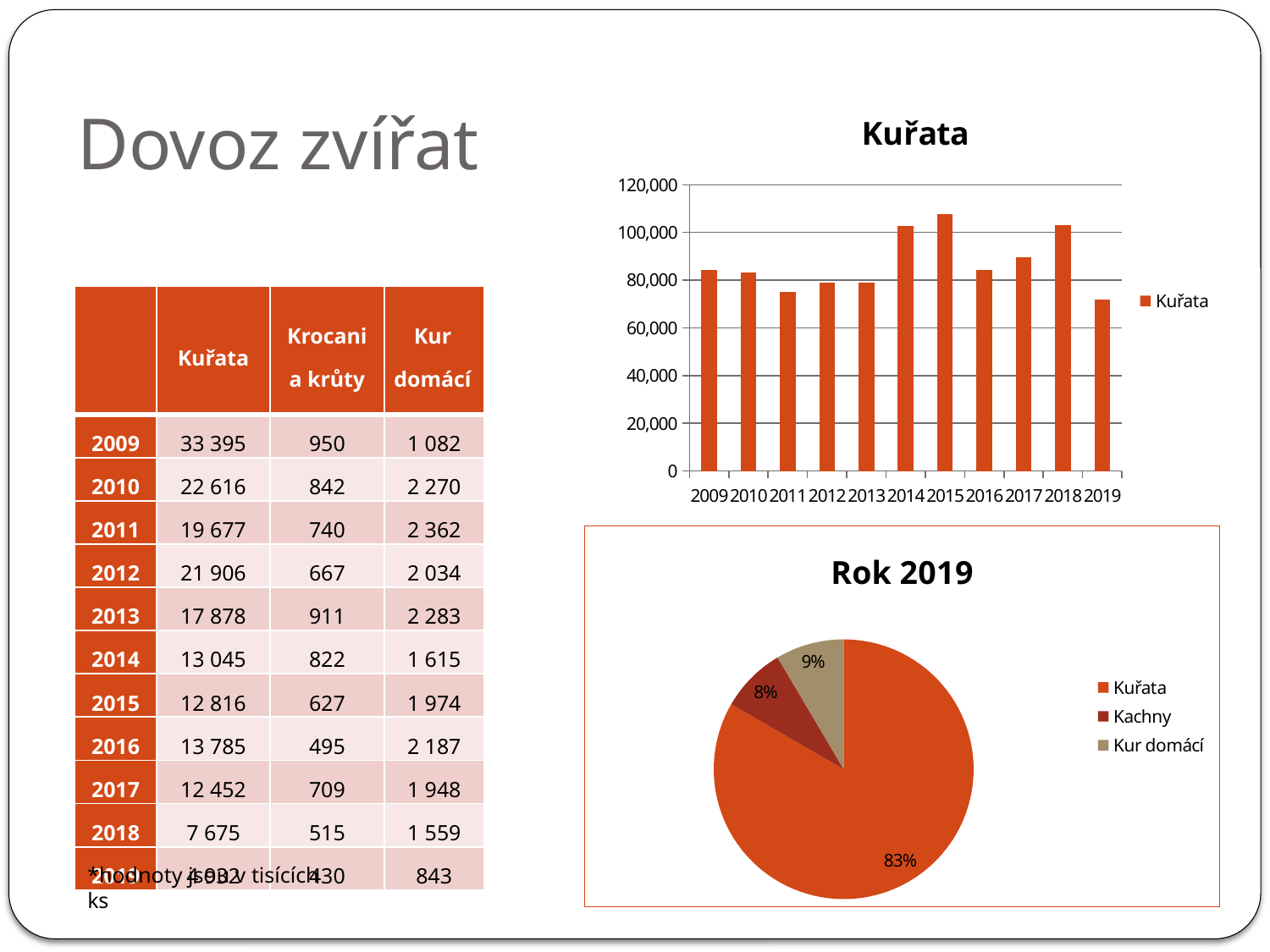
What kind of chart is the 'Kuřata' chart? bar chart How many years are shown on the x axis of the 'Kuřata' chart? 11 In the 'Kuřata' chart, which year has the highest value? 2015 In the 'Kuřata' chart, is the value for 2014 greater or less than 100,000? greater In the 'Rok 2019' pie chart, what share does Kuřata have? 83% In the 'Kuřata' chart, is the value for 2017 greater or less than 80,000? greater In the 'Rok 2019' pie chart, what is the value for Kachny? 8% In the 'Rok 2019' pie chart, which is larger, Kachny or Kur domácí? Kur domácí How many series does the legend of the 'Kuřata' chart list? 1 In the 'Kuřata' chart, which year has the lowest value? 2019 In the 'Rok 2019' pie chart, what is the difference between the Kuřata share and the Kur domácí share? 74 percentage points In the 'Kuřata' chart, is the value for 2011 greater or less than 80,000? less